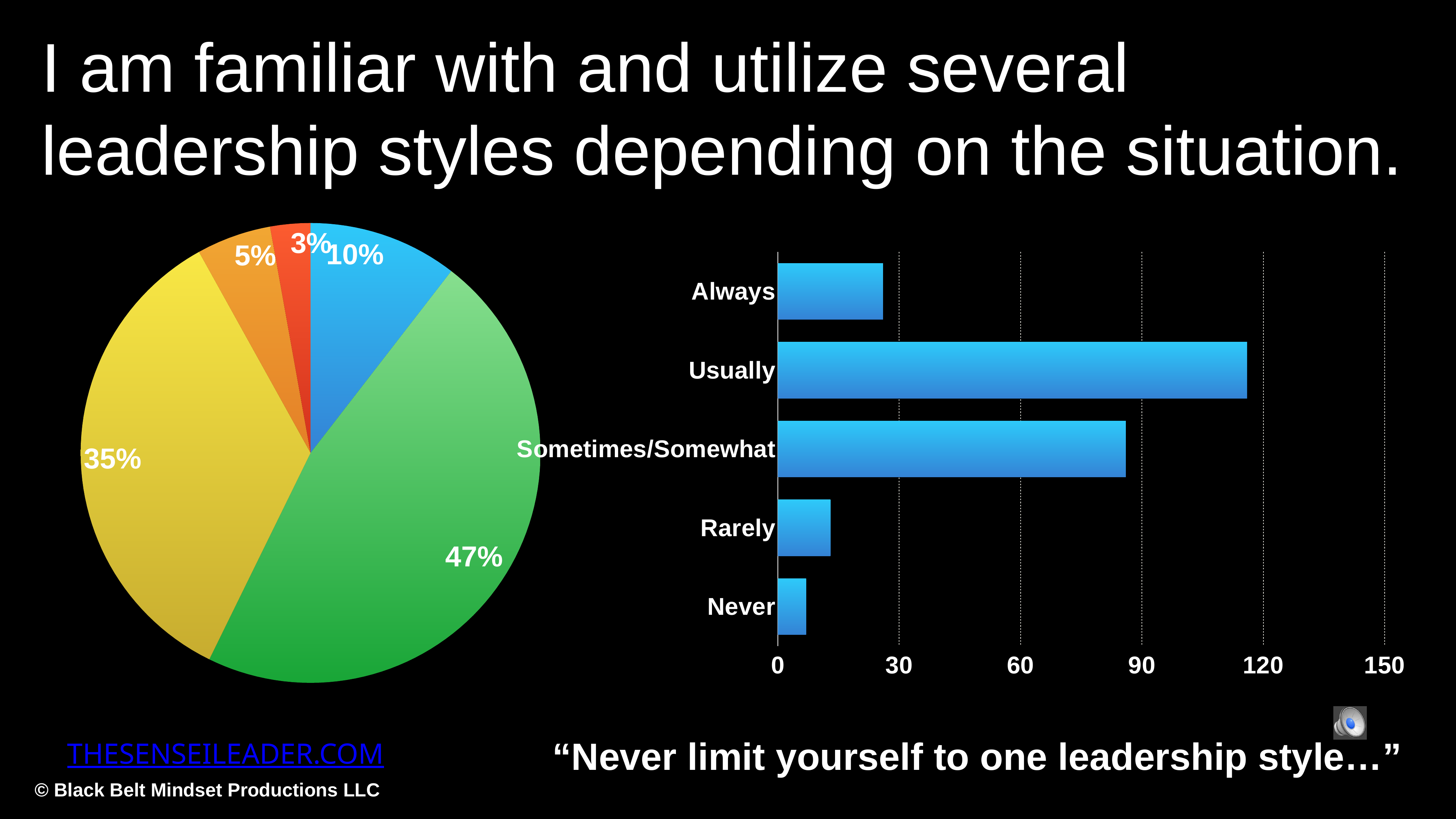
How many slices does the pie chart on the left have? 5 In the bar chart on the right, which category has the shortest bar? Never In the pie chart on the left, what percentage is shown on the yellow slice? 35% How many categories does the bar chart on the right show? 5 In the bar chart on the right, is the value for Always greater or less than 30? less In the bar chart on the right, which category has the longest bar? Usually What kind of chart is on the left side of the slide? Pie chart In the pie chart on the left, what is the smallest slice's percentage? 3% What kind of chart is on the right side of the slide? Bar chart In the pie chart on the left, what is the largest slice's percentage? 47% In the pie chart on the left, what percentage is shown on the green slice? 47% In the bar chart on the right, is the value for Usually greater or less than 90? greater